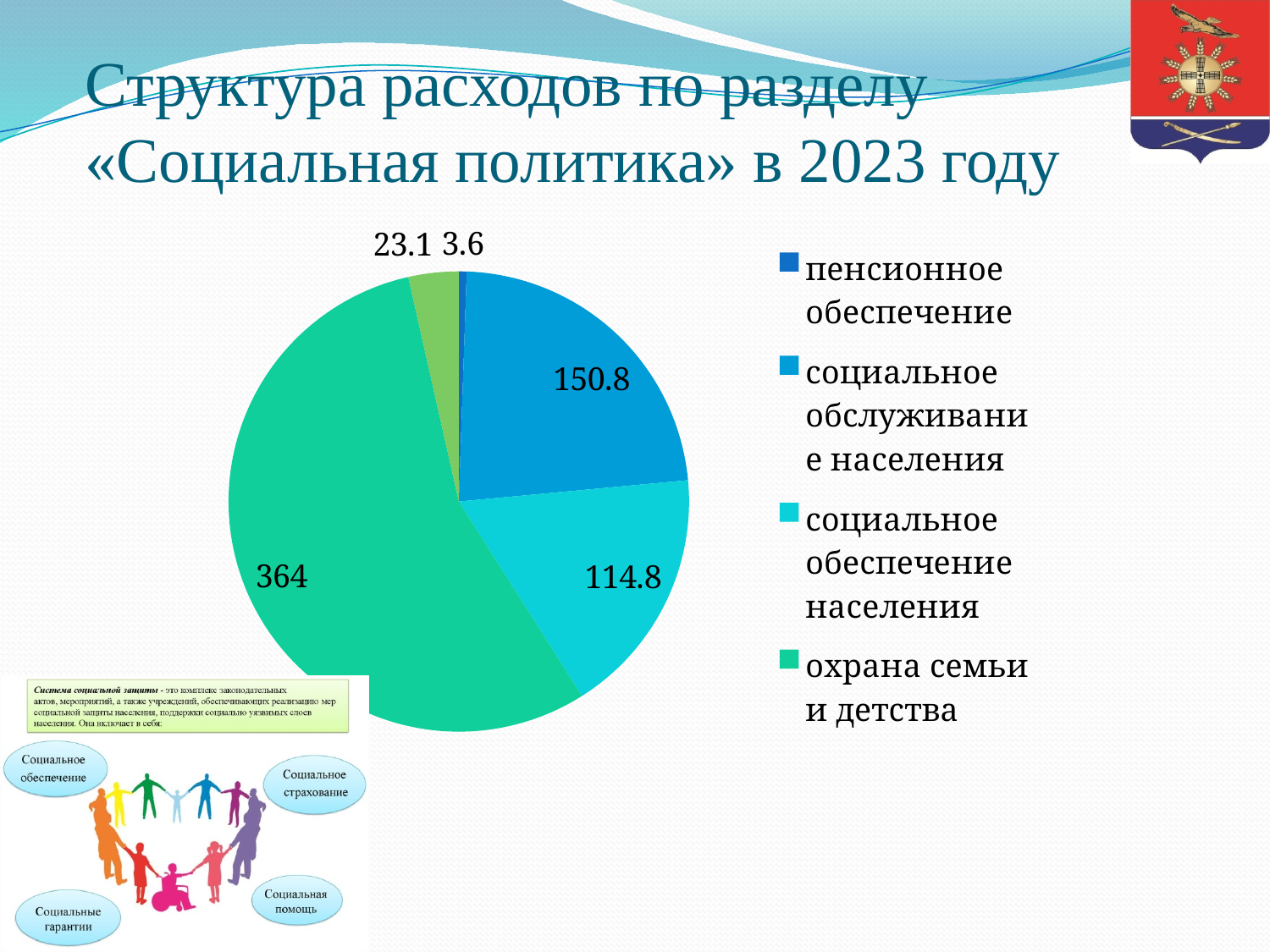
Which is larger: социальное обслуживание населения or социальное обеспечение населения? социальное обслуживание населения Which legend category has the smallest slice in the pie chart? пенсионное обеспечение Which legend category has the largest slice in the pie chart? охрана семьи и детства How many entries does the legend of the pie chart list? 4 What is the value for социальное обеспечение населения in the pie chart? 114.8 What is the value for пенсионное обеспечение in the pie chart? 3.6 What is the value for социальное обслуживание населения in the pie chart? 150.8 What is the value for охрана семьи и детства in the pie chart? 364 What kind of chart is shown on the slide? pie chart What is the difference between the values for охрана семьи и детства and социальное обслуживание населения? 213.2 What is the difference between the values for социальное обслуживание населения and социальное обеспечение населения? 36 How many slices does the pie chart have? 5